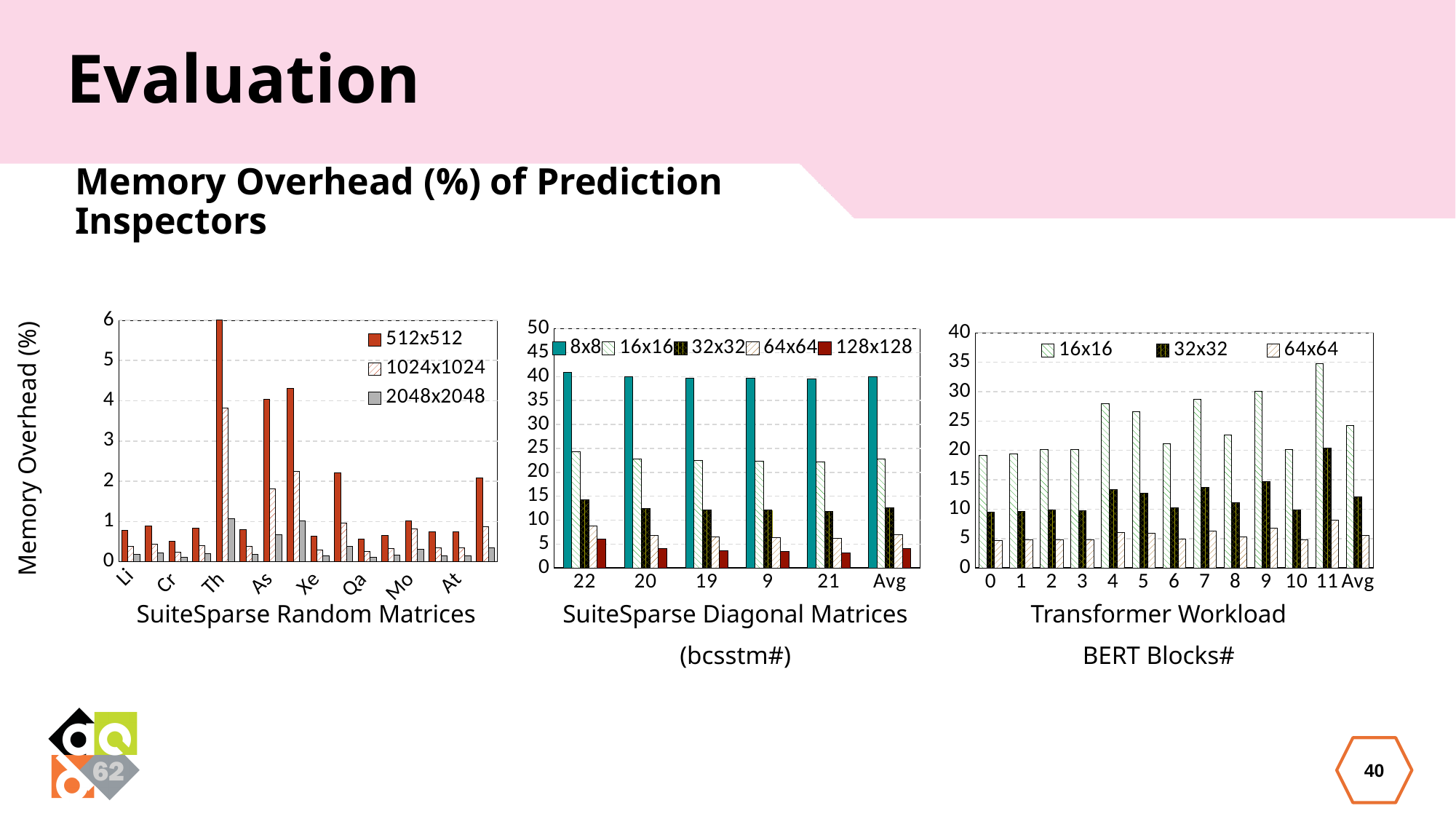
On the Transformer Workload chart, is the 32x32 value for block 11 greater or less than 15? greater On the SuiteSparse Random Matrices chart, which matrix has the highest 512x512 bar? Th On the Transformer Workload chart, which BERT block has the highest 16x16 bar? 11 On the SuiteSparse Diagonal Matrices chart, is the 8x8 value for bcsstm 22 greater or less than 35? greater On the SuiteSparse Random Matrices chart, is the 512x512 value for Th greater or less than 5? greater On the SuiteSparse Diagonal Matrices chart, how many series does the legend list? 5 On the SuiteSparse Random Matrices chart, which is larger for As: the 512x512 bar or the 2048x2048 bar? 512x512 On the SuiteSparse Random Matrices chart, how many series does the legend list? 3 What kind of chart is the Transformer Workload chart? bar chart On the SuiteSparse Diagonal Matrices chart, which series has the lowest bar for Avg? 128x128 On the SuiteSparse Diagonal Matrices chart, how many categories are on the x axis? 6